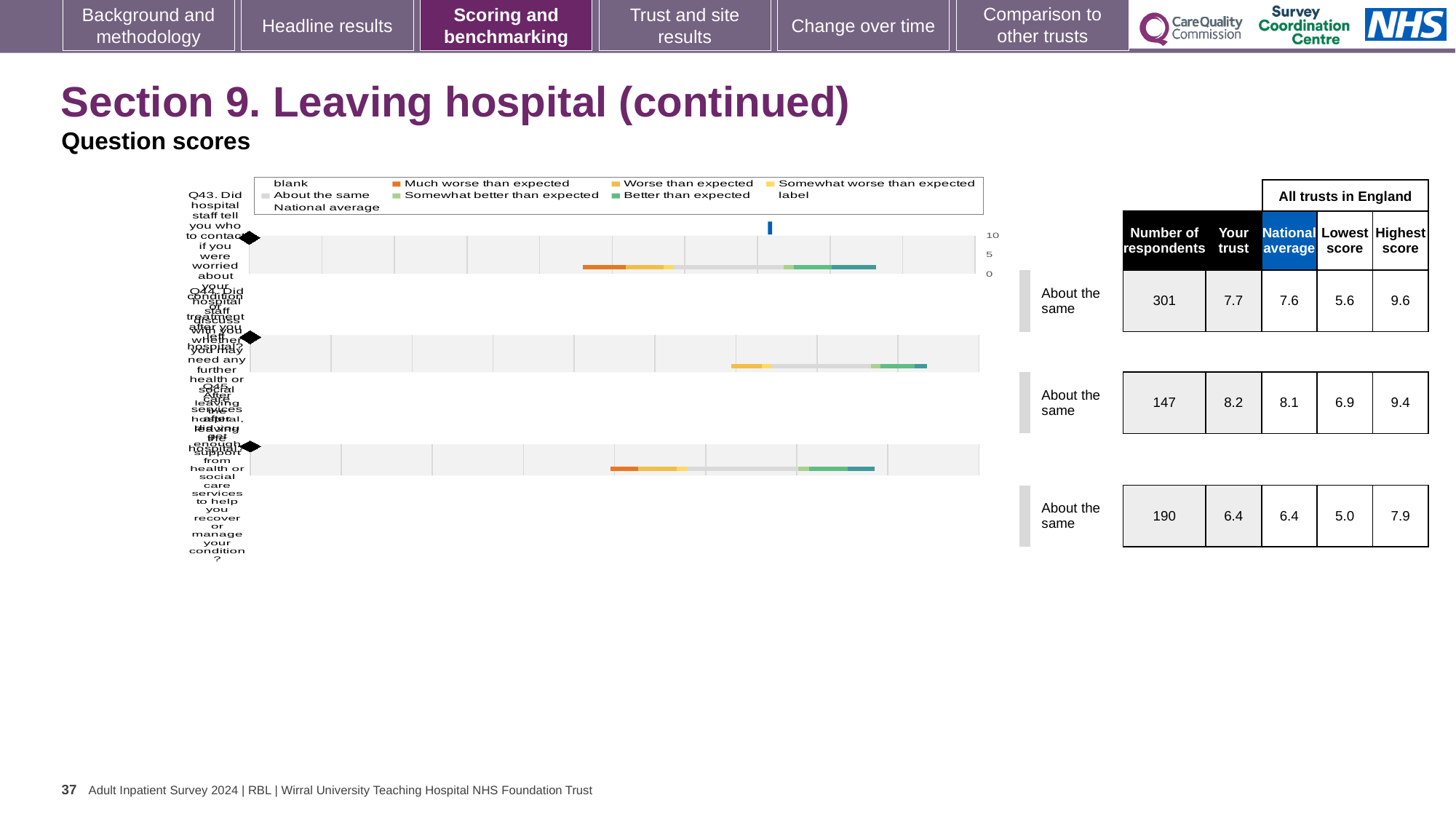
What is the highest score for the third row of the table? 7.9 What is the 'Your trust' score for Q43 (the first row)? 7.7 How many question bars are plotted in the chart? 3 Which row has the highest 'Your trust' score? the second row (8.2) What benchmark category is shown next to each of the three bars? About the same What is the number of respondents for Q43 (the first row)? 301 What kind of chart is shown on the slide? bar chart What is the national average for the second row of the table? 8.1 Which row has the lowest 'Your trust' score? the third row (6.4) In the chart legend, which label corresponds to the orange colour? Much worse than expected For Q43, which is larger: the 'Your trust' score or the national average? Your trust For Q43, what is the difference between the 'Your trust' score and the national average? 0.1